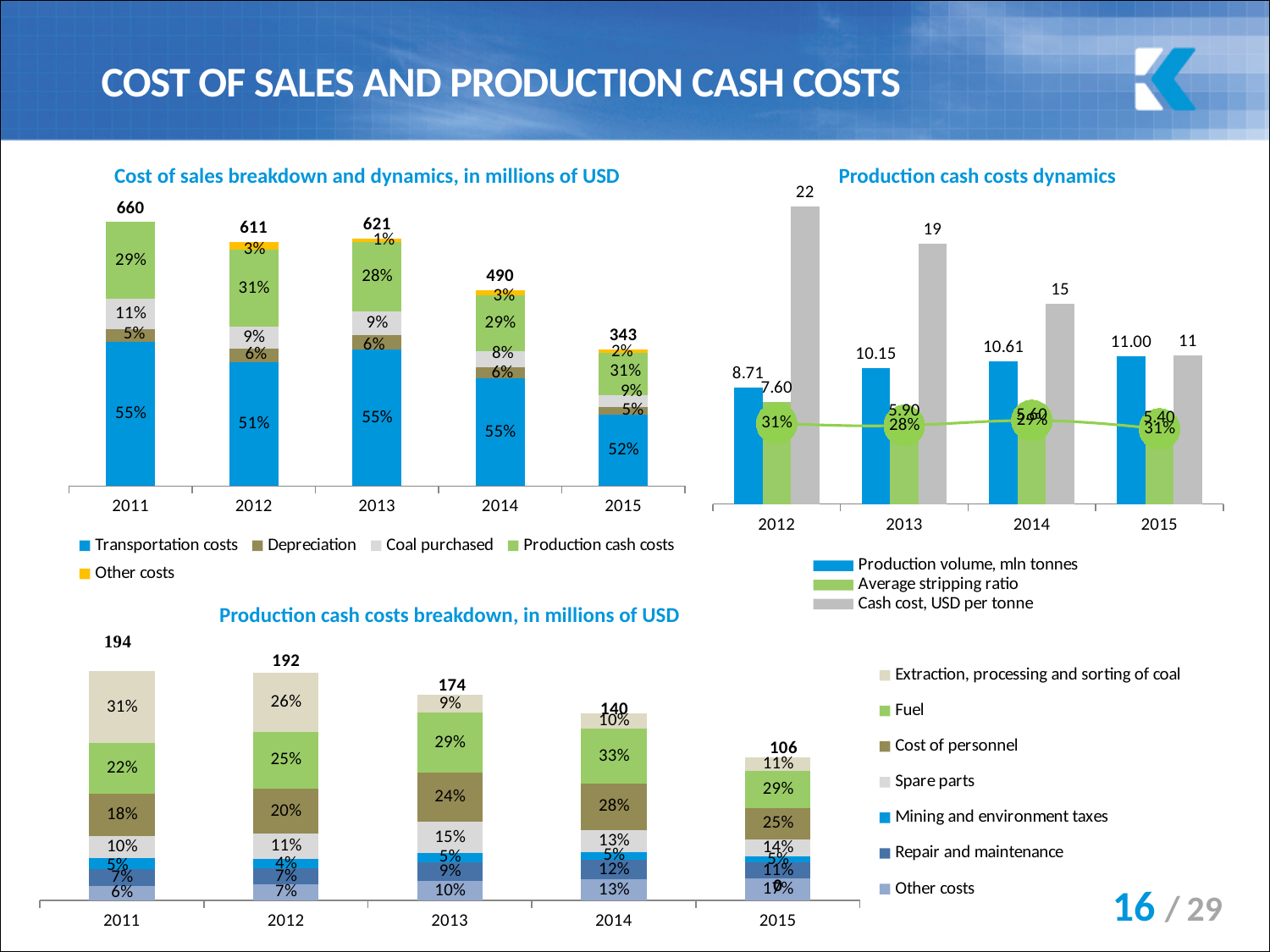
What type of chart is the 'Production cash costs breakdown, in millions of USD' chart? stacked bar chart In the 'Production cash costs dynamics' chart, what is the cash cost in USD per tonne for 2012? 22 In the 'Cost of sales breakdown and dynamics' chart, what is the total cost of sales for 2011? 660 In the 'Production cash costs breakdown' chart, what is the total for 2015? 106 In the 'Production cash costs dynamics' chart, which is larger: the average stripping ratio in 2012 or in 2015? 2012 In the 'Cost of sales breakdown and dynamics' chart, what is the difference between the 2013 total and the 2014 total? 131 In the 'Cost of sales breakdown and dynamics' chart, which year has the lowest total cost of sales? 2015 In the 'Production cash costs breakdown' chart, what share of the 2014 total is fuel? 33% How many series does the legend of the 'Cost of sales breakdown and dynamics' chart list? 5 In the 'Cost of sales breakdown and dynamics' chart, what share of the 2012 total is transportation costs? 51% In the 'Production cash costs dynamics' chart, does the cash cost per tonne rise or fall from 2012 to 2015? fall In the 'Production cash costs dynamics' chart, what is the production volume in 2013? 10.15